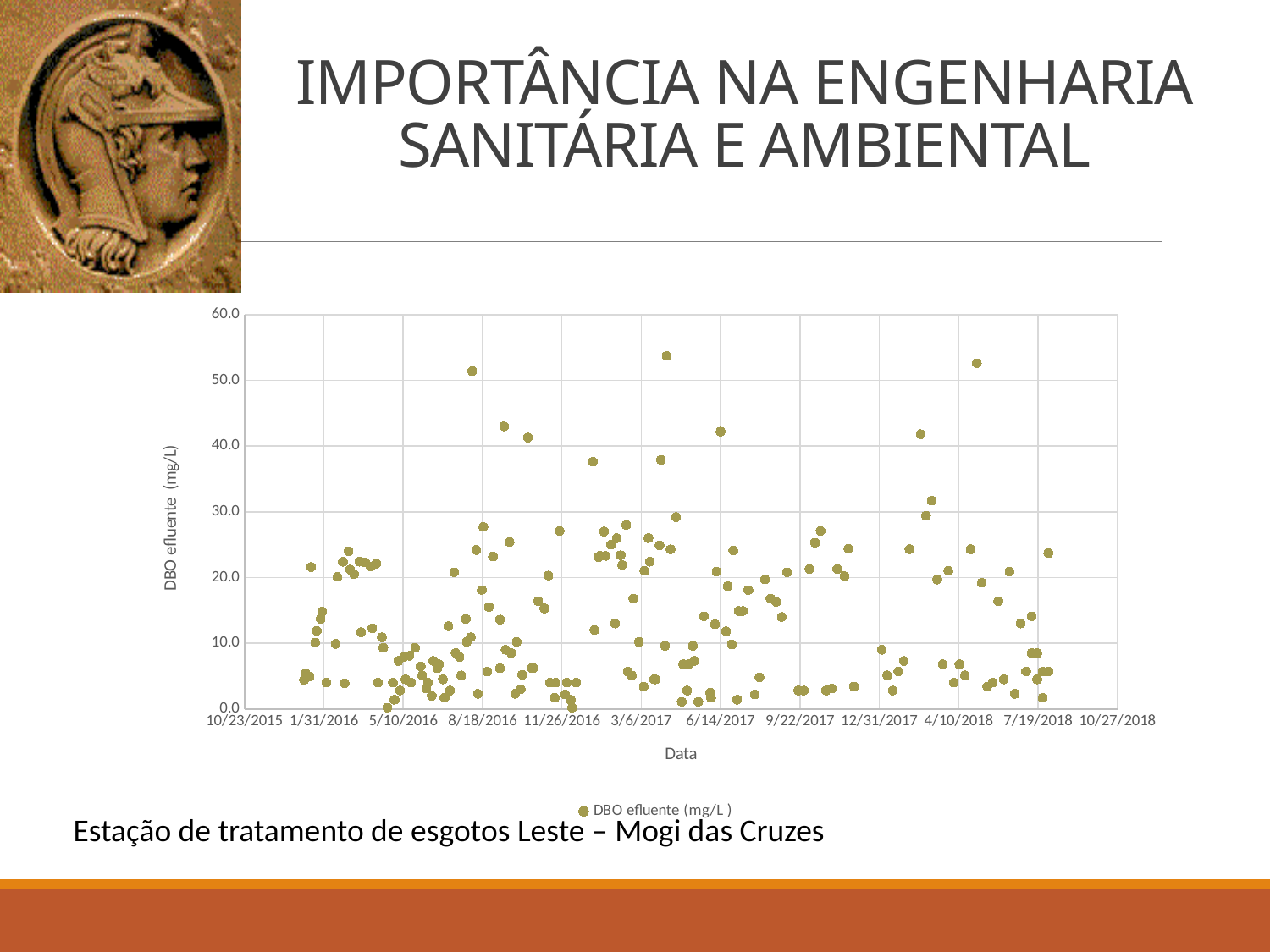
Are the majority of the plotted points above or below 30.0 mg/L? below Is the lowest plotted DBO efluente value greater or less than 10.0? less Is the highest plotted DBO efluente value greater or less than 60.0? less What is the legend entry of the series plotted in the chart? DBO efluente (mg/L ) How many series does the chart legend list? 1 What kind of chart is shown on the slide? scatter chart What is the label of the x axis of the chart? Data